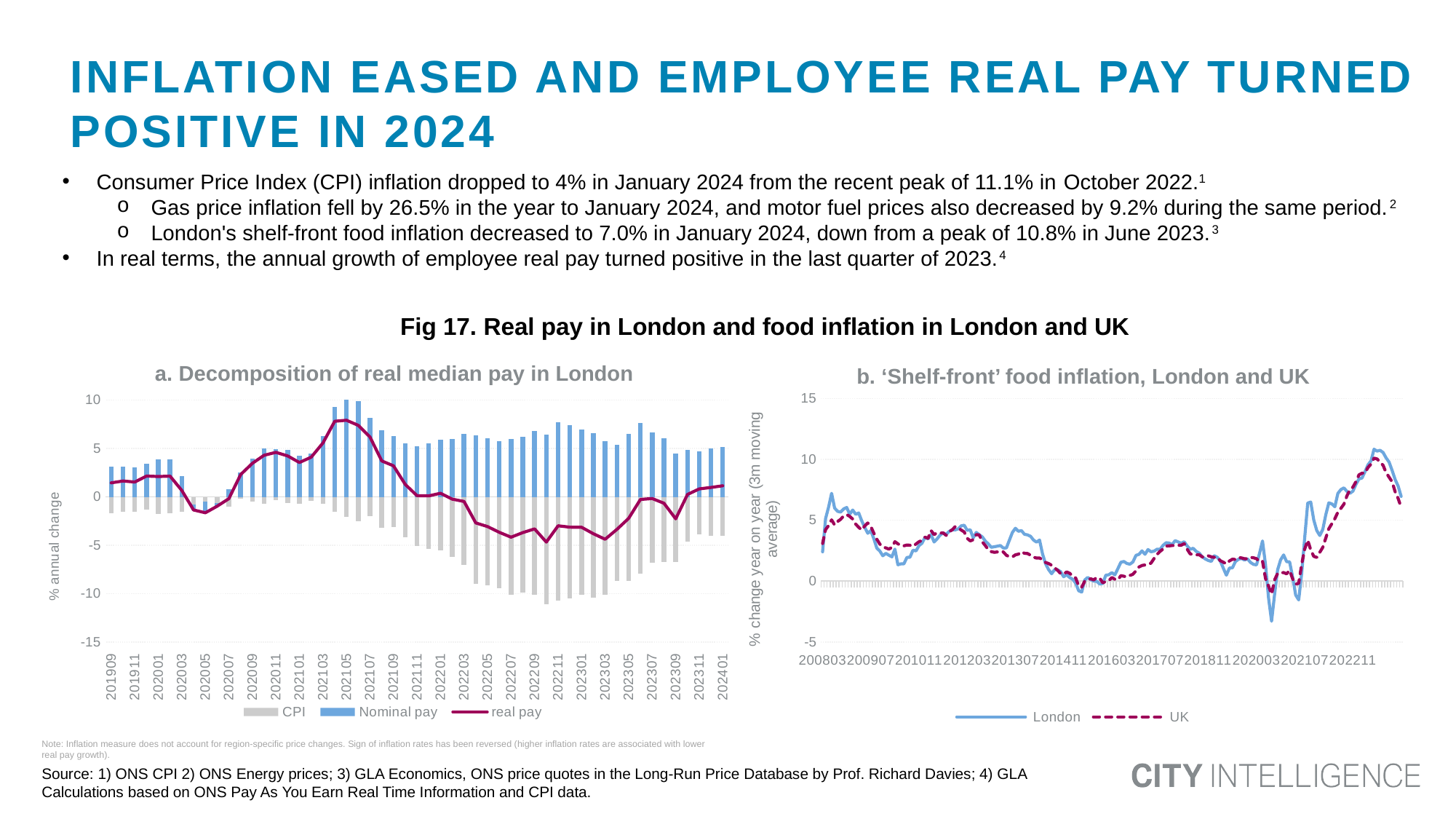
In chart a, 'Decomposition of real median pay in London', around which x-axis label does the Nominal pay series reach its highest value? 202105 In chart a, 'Decomposition of real median pay in London', is the Nominal pay value for 202105 greater or less than 5? greater In chart b, 'Shelf-front food inflation, London and UK', how many series does the legend list? 2 In chart b, 'Shelf-front food inflation, London and UK', is the peak London value in 2023 greater or less than 10? greater In chart a, 'Decomposition of real median pay in London', is the CPI value for 202211 greater or less than -5? less In chart a, 'Decomposition of real median pay in London', which is larger at 202105: Nominal pay or real pay? Nominal pay What kind of chart is chart b, 'Shelf-front food inflation, London and UK'? Line chart In chart a, 'Decomposition of real median pay in London', how many series does the legend list? 3 In chart a, 'Decomposition of real median pay in London', which series is drawn as a line rather than bars? real pay In chart b, 'Shelf-front food inflation, London and UK', what is the y-axis label? % change year on year (3m moving average) In chart b, 'Shelf-front food inflation, London and UK', which series falls lower in the 2020 dip: London or UK? London